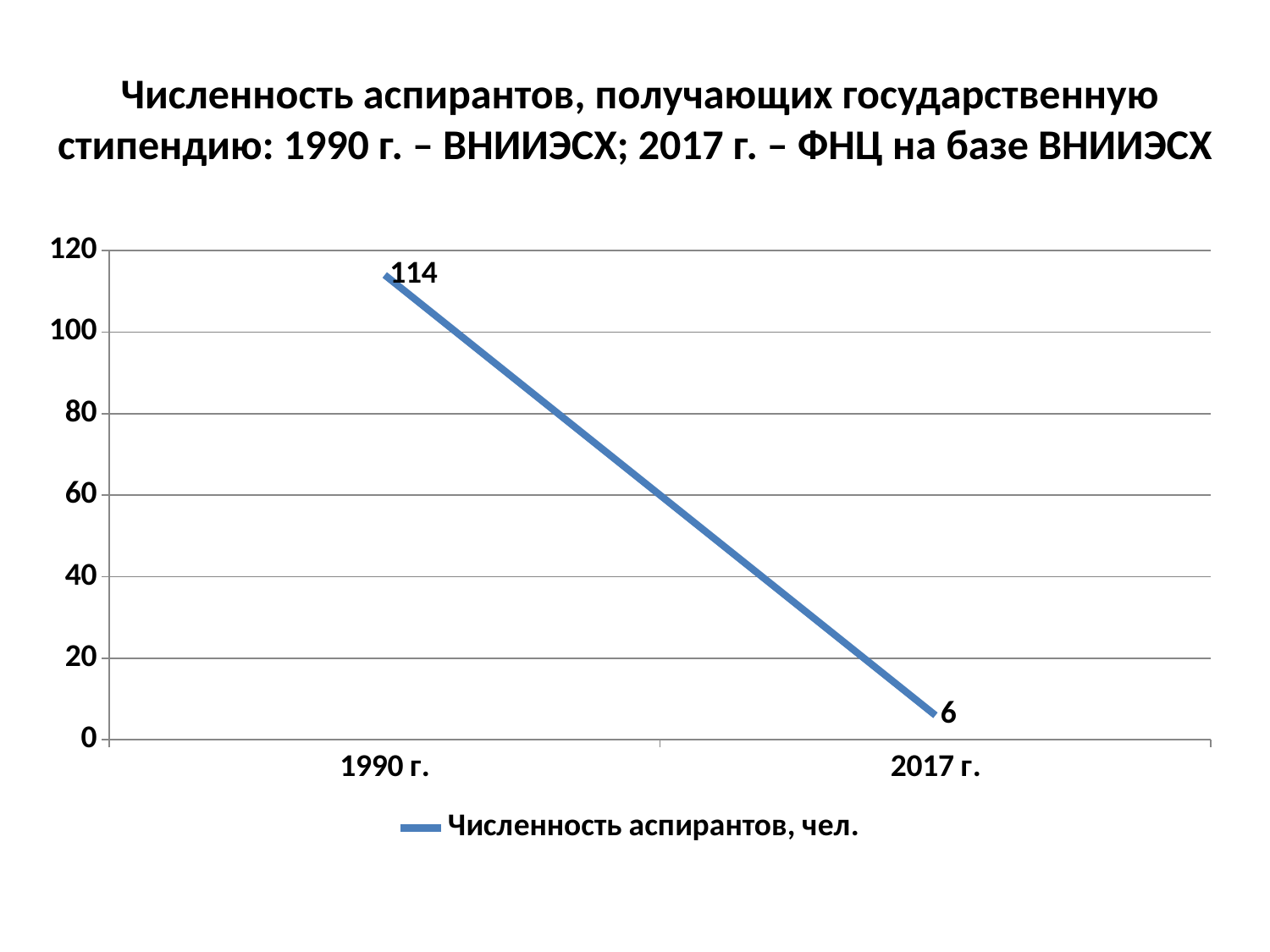
What kind of chart is shown on the slide? line chart What is the value for 2017 г.? 6 Which year has the highest number of postgraduate students? 1990 г. Is the value for 1990 г. greater or less than 100? greater What is the difference between the values for 1990 г. and 2017 г.? 108 Which is larger, the value for 1990 г. or the value for 2017 г.? 1990 г. Is the value for 2017 г. greater or less than 20? less What is the value for 1990 г.? 114 How many series does the legend list? 1 Which year has the lowest number of postgraduate students? 2017 г. Do the values rise or fall from 1990 г. to 2017 г.? fall How many data points are plotted on the chart? 2